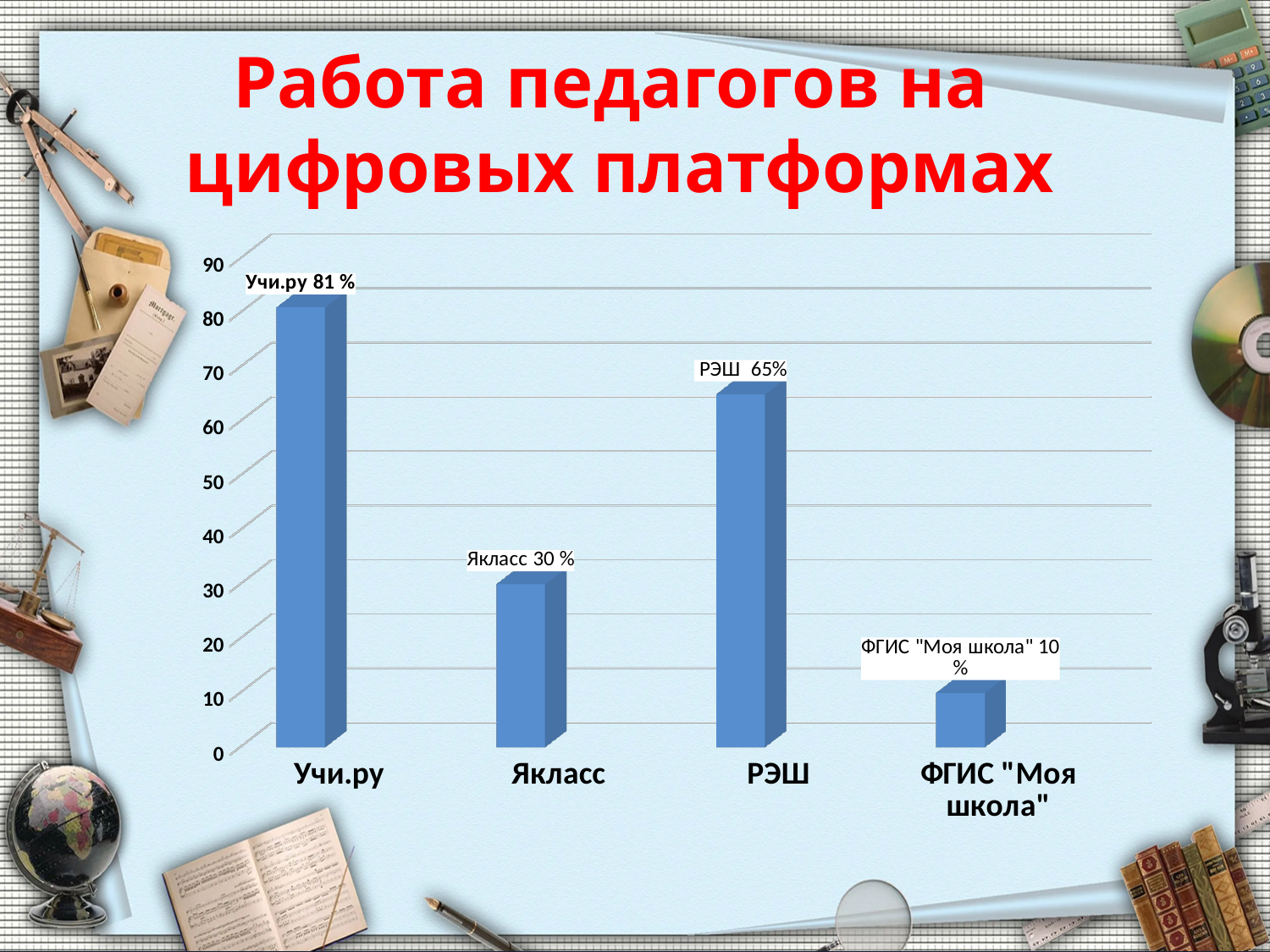
Which platform has the highest value? Учи.ру Which platform has the lowest value? ФГИС "Моя школа" What is the value shown for РЭШ? 65% What is the value shown for Учи.ру? 81 % What is the title of the slide? Работа педагогов на цифровых платформах What is the value shown for Якласс? 30 % What is the difference between the values for РЭШ and ФГИС "Моя школа"? 55 How many platforms are shown on the chart? 4 What is the difference between the values for Учи.ру and Якласс? 51 Which is larger, the value for РЭШ or the value for Якласс? РЭШ What is the value shown for ФГИС "Моя школа"? 10 % What kind of chart is shown on the slide? Bar chart